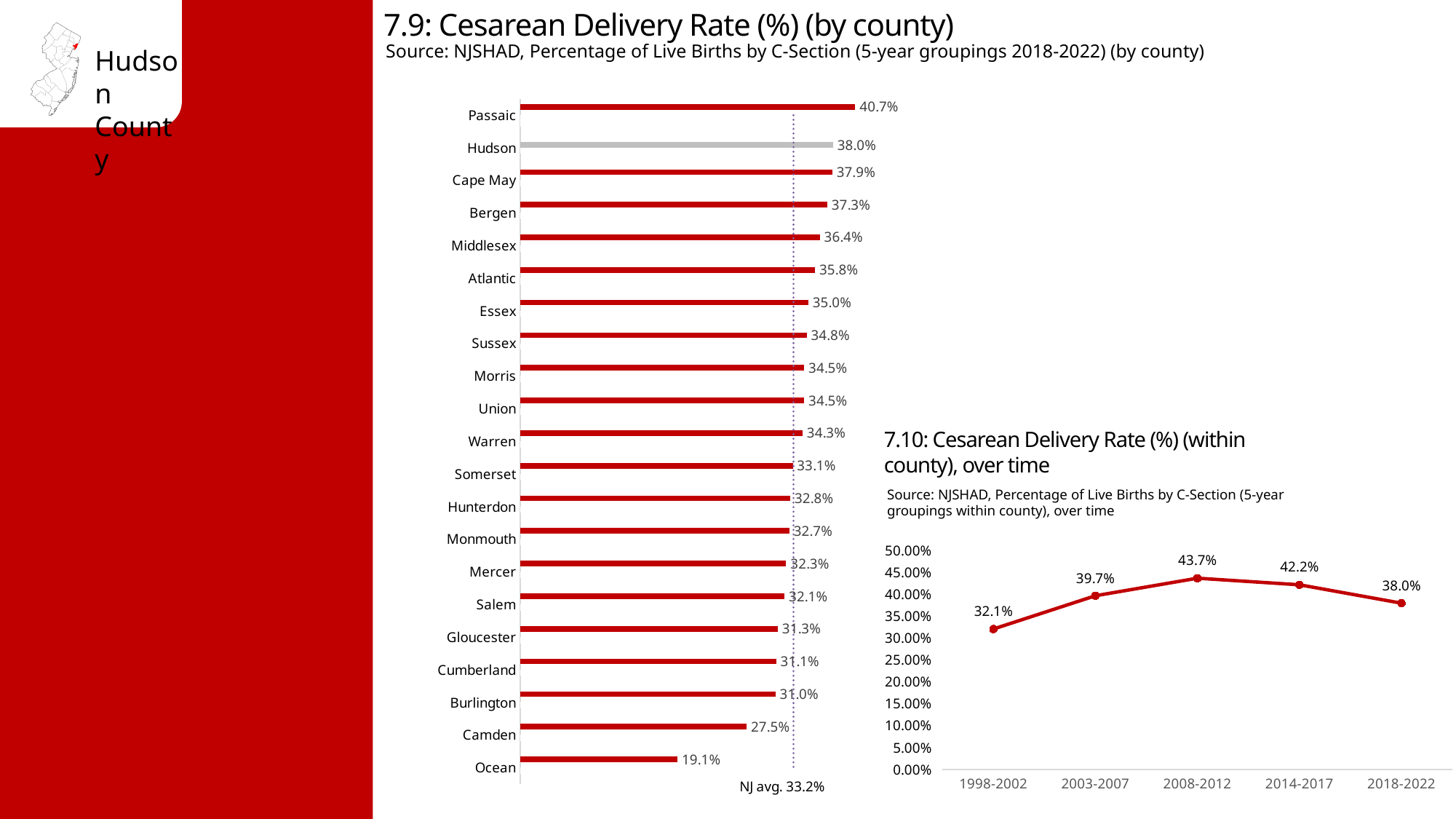
In the chart '7.9: Cesarean Delivery Rate (%) (by county)', what is the value for Hudson? 38.0% In the chart '7.9: Cesarean Delivery Rate (%) (by county)', what is the difference between the values for Passaic and Ocean? 21.6% In the chart '7.9: Cesarean Delivery Rate (%) (by county)', how many counties are plotted? 21 In the chart '7.9: Cesarean Delivery Rate (%) (by county)', which county has the lowest cesarean delivery rate? Ocean What kind of chart is '7.10: Cesarean Delivery Rate (%) (within county), over time'? Line chart In the chart '7.10: Cesarean Delivery Rate (%) (within county), over time', what is the value for 2008-2012? 43.7% In the chart '7.9: Cesarean Delivery Rate (%) (by county)', which is larger, the value for Camden or the value for Burlington? Burlington In the chart '7.9: Cesarean Delivery Rate (%) (by county)', which county has the highest cesarean delivery rate? Passaic In the chart '7.10: Cesarean Delivery Rate (%) (within county), over time', what is the difference between the values for 2008-2012 and 2018-2022? 5.7% What kind of chart is '7.9: Cesarean Delivery Rate (%) (by county)'? Bar chart In the chart '7.9: Cesarean Delivery Rate (%) (by county)', what NJ average is marked by the dotted line? 33.2% In the chart '7.10: Cesarean Delivery Rate (%) (within county), over time', which period has the lowest value? 1998-2002